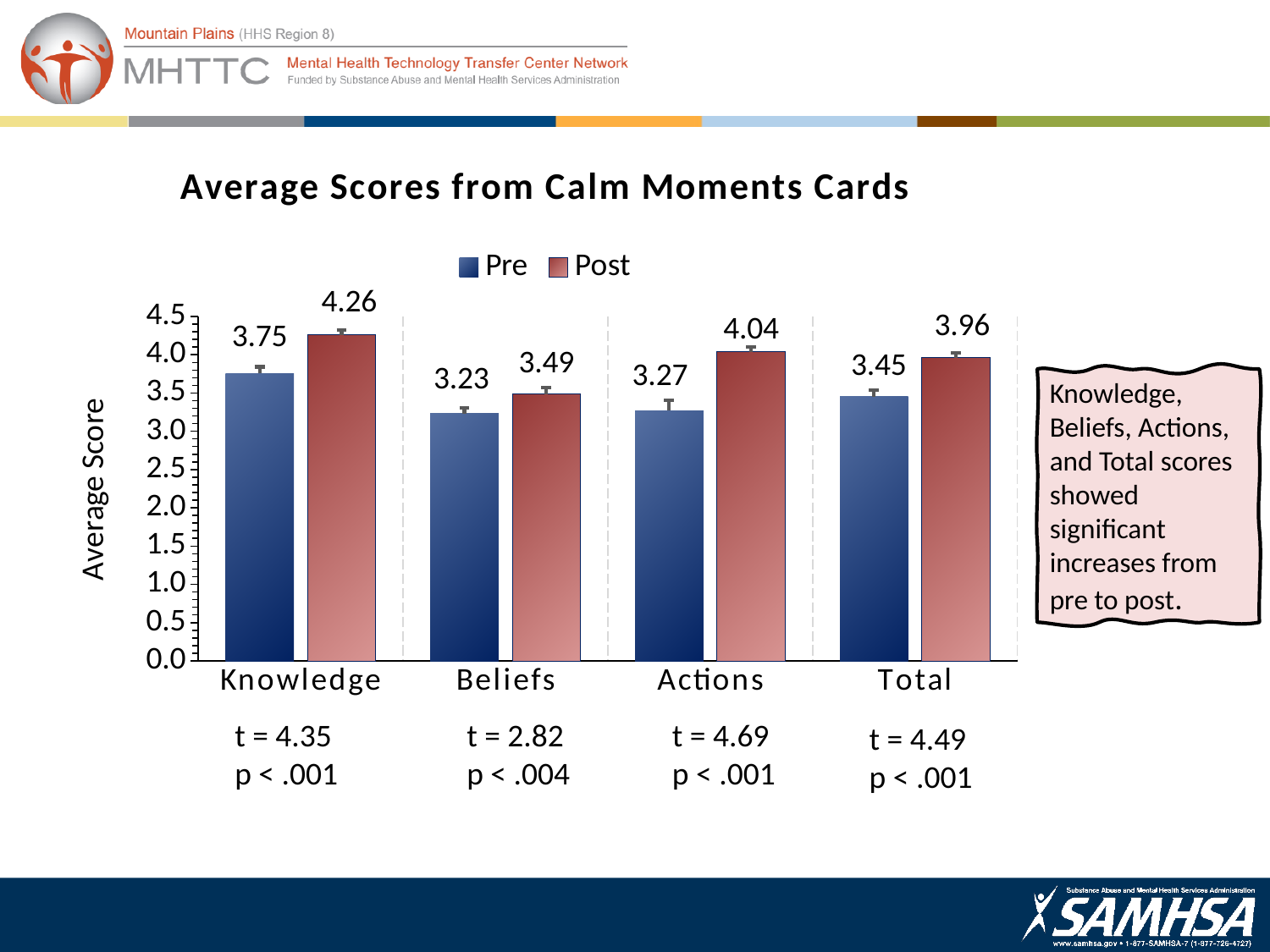
How many categories are shown on the x axis? 4 What is the Post value for Actions? 4.04 What is the Pre value for Knowledge? 3.75 How many series does the legend list? 2 What is the difference between the Post and Pre values for Actions? 0.77 What is the Pre value for Total? 3.45 Which is larger, the Pre value for Knowledge or the Post value for Beliefs? Pre value for Knowledge What is the difference between the Post and Pre values for Beliefs? 0.26 Which category has the highest Post value? Knowledge What is the title of the chart? Average Scores from Calm Moments Cards Which category has the lowest Pre value? Beliefs What kind of chart is shown on the slide? Bar chart